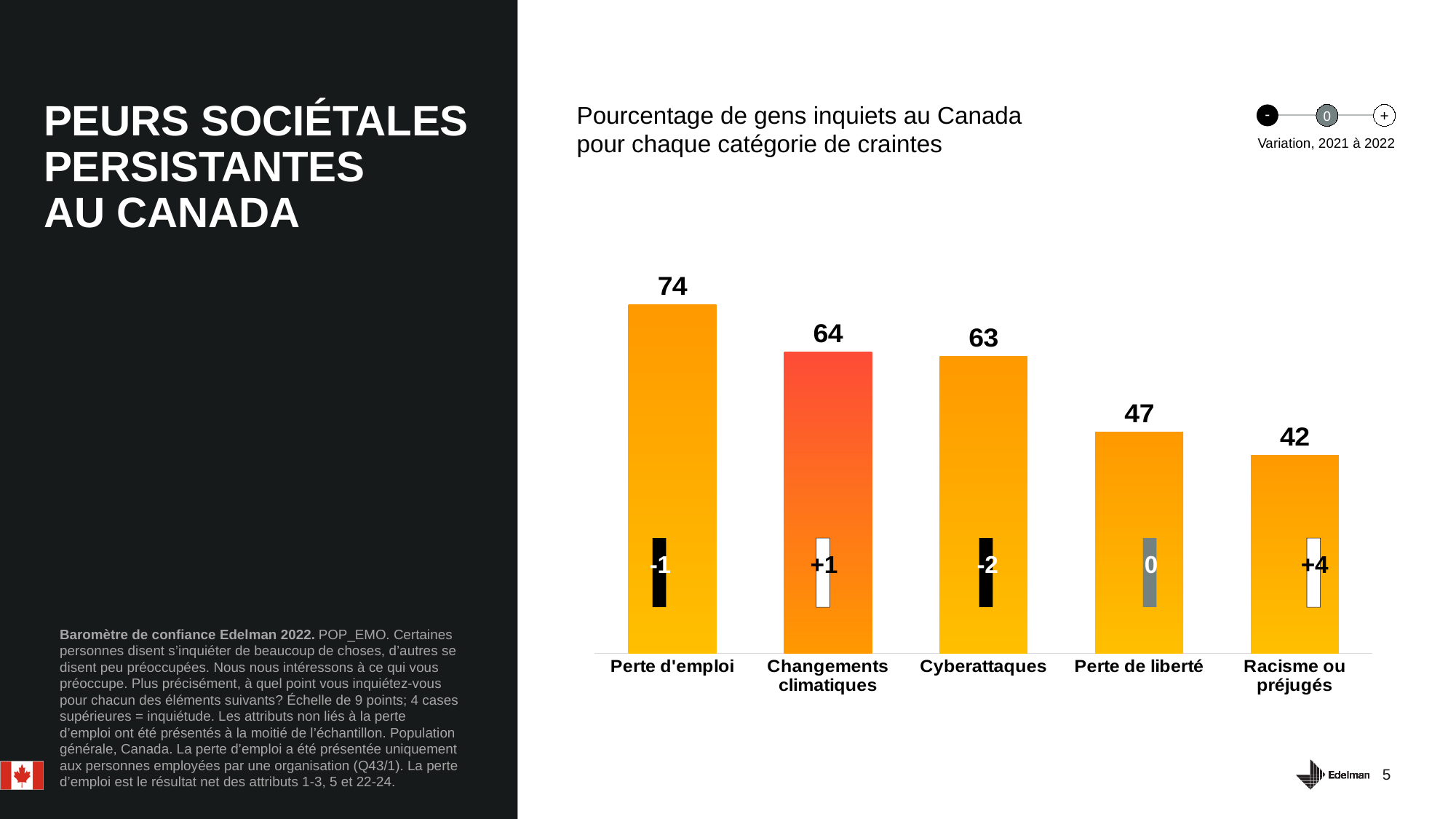
How many categories are shown in the chart? 5 What is the difference between the values for Perte d'emploi and Perte de liberté? 27 Which is larger, the value for Cyberattaques or the value for Perte de liberté? Cyberattaques Do the values rise or fall from left to right across the categories? Fall Which category has the highest value? Perte d'emploi What is the value for Changements climatiques? 64 What is the value for Racisme ou préjugés? 42 What is the value for Perte d'emploi? 74 What kind of chart is shown on the slide? Bar chart What is the variation from 2021 to 2022 shown for Racisme ou préjugés? +4 What is the variation from 2021 to 2022 shown for Cyberattaques? -2 Which category has the lowest value? Racisme ou préjugés